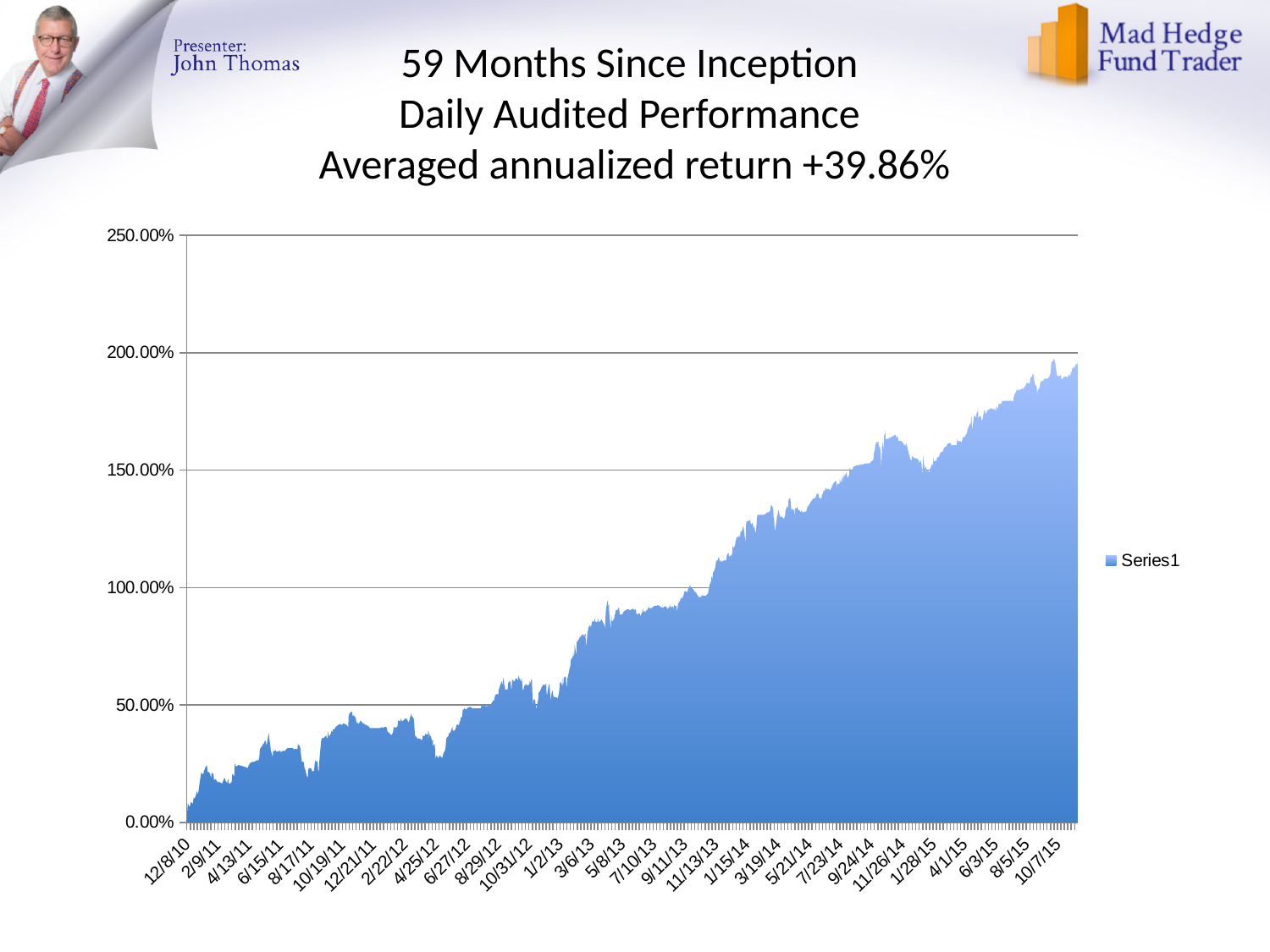
What is the name of the series shown in the legend? Series1 What is the highest value shown on the y axis? 250.00% Do the values generally rise or fall from 12/8/10 to 10/7/15? rise What averaged annualized return does the chart title state? +39.86% How many series does the legend list? 1 What kind of chart is shown on the slide? area chart Is the value at 3/19/14 greater or less than 100.00%? greater Is the value at 4/1/15 greater or less than 150.00%? greater Which date has the larger value, 8/29/12 or 3/6/13? 3/6/13 Is the value at 10/7/15 greater or less than 150.00%? greater